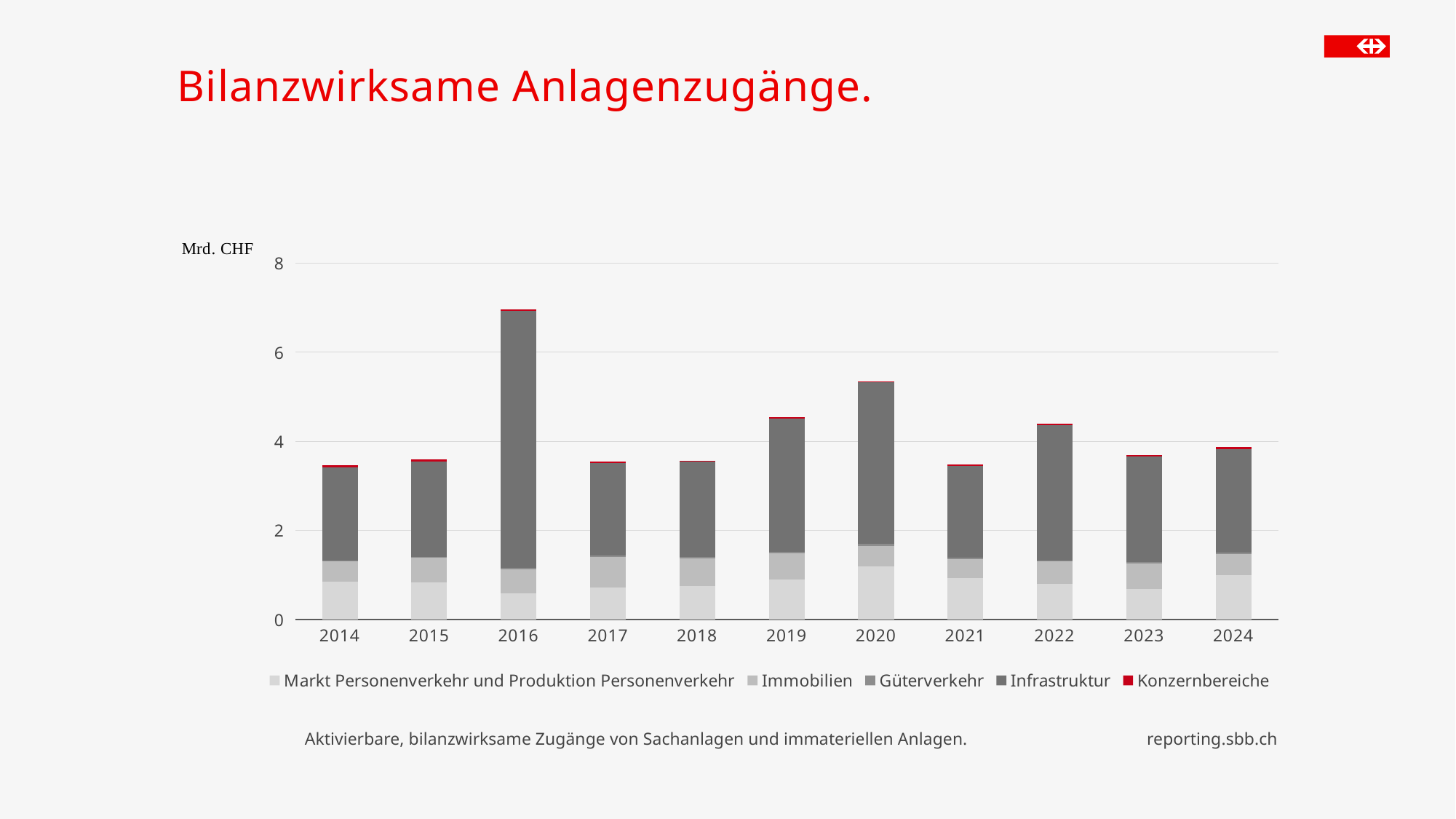
Is the total value for 2016 greater or less than 6? greater Which year has the larger total bar, 2019 or 2020? 2020 What unit is shown on the y axis of the chart? Mrd. CHF Is the total value for 2014 greater or less than 4? less Is the total value for 2018 greater or less than 4? less What is the title of the chart on the slide? Bilanzwirksame Anlagenzugänge. Which year has the highest total bar? 2016 How many years are shown on the x axis of the chart? 11 How many series does the legend list? 5 What kind of chart is shown on the slide? Stacked bar chart